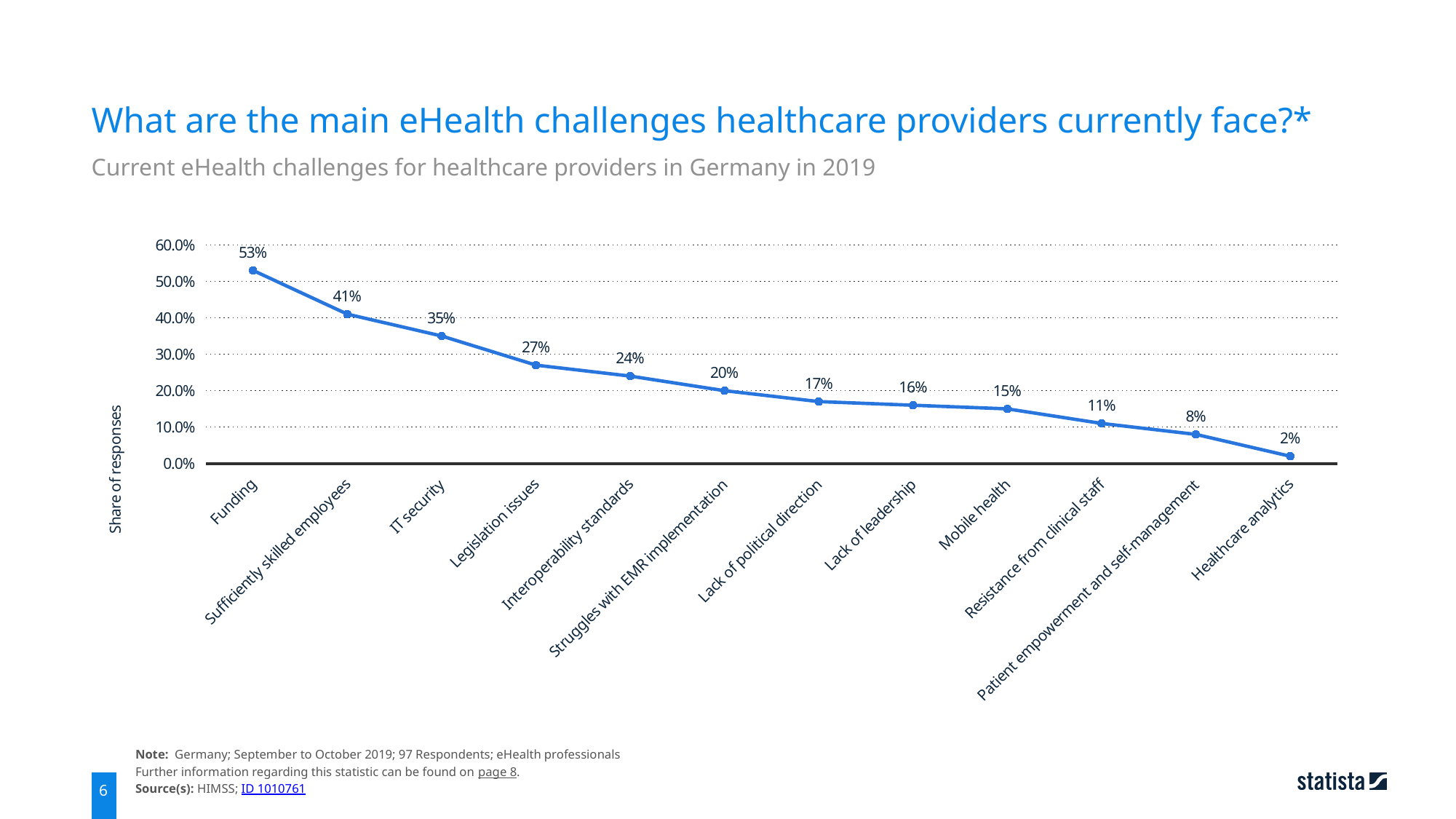
What share of responses is shown for Patient empowerment and self-management? 8% What share of responses is shown for IT security? 35% How many challenges are plotted on the chart? 12 Which challenge has the lowest share of responses? Healthcare analytics What share of responses is shown for Lack of leadership? 16% What is the difference between the shares for Funding and Sufficiently skilled employees? 12% Which has a larger share of responses, Legislation issues or Interoperability standards? Legislation issues What share of responses is shown for Funding? 53% What is the label of the vertical axis? Share of responses What kind of chart is shown on the slide? Line chart Which challenge has the highest share of responses? Funding Do the values rise or fall from left to right along the x axis? Fall